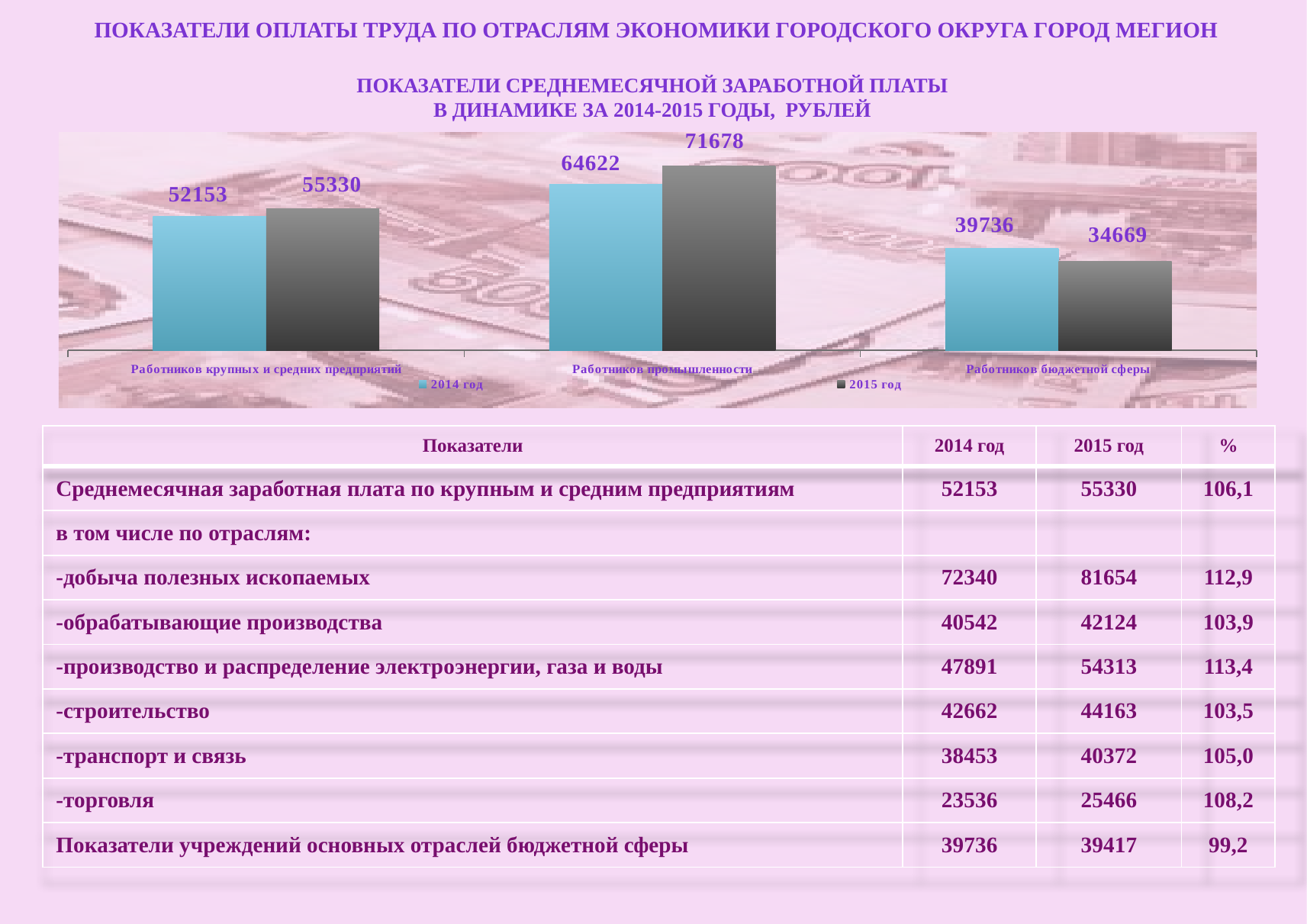
What is the 2015 value for Работников промышленности? 71678 What is the 2014 value for Работников бюджетной сферы? 39736 What is the 2015 value for Работников бюджетной сферы? 34669 What type of chart is shown on the slide? Bar chart What is the difference between the 2015 and 2014 values for Работников промышленности? 7056 What is the 2014 value for Работников крупных и средних предприятий? 52153 For Работников бюджетной сферы, which is larger: the 2014 value or the 2015 value? 2014 год How many categories are shown on the x axis of the chart? 3 Which category has the lowest 2014 value? Работников бюджетной сферы Which category has the highest 2015 value? Работников промышленности How many series does the chart legend list? 2 Which series is shown in light blue in the chart? 2014 год